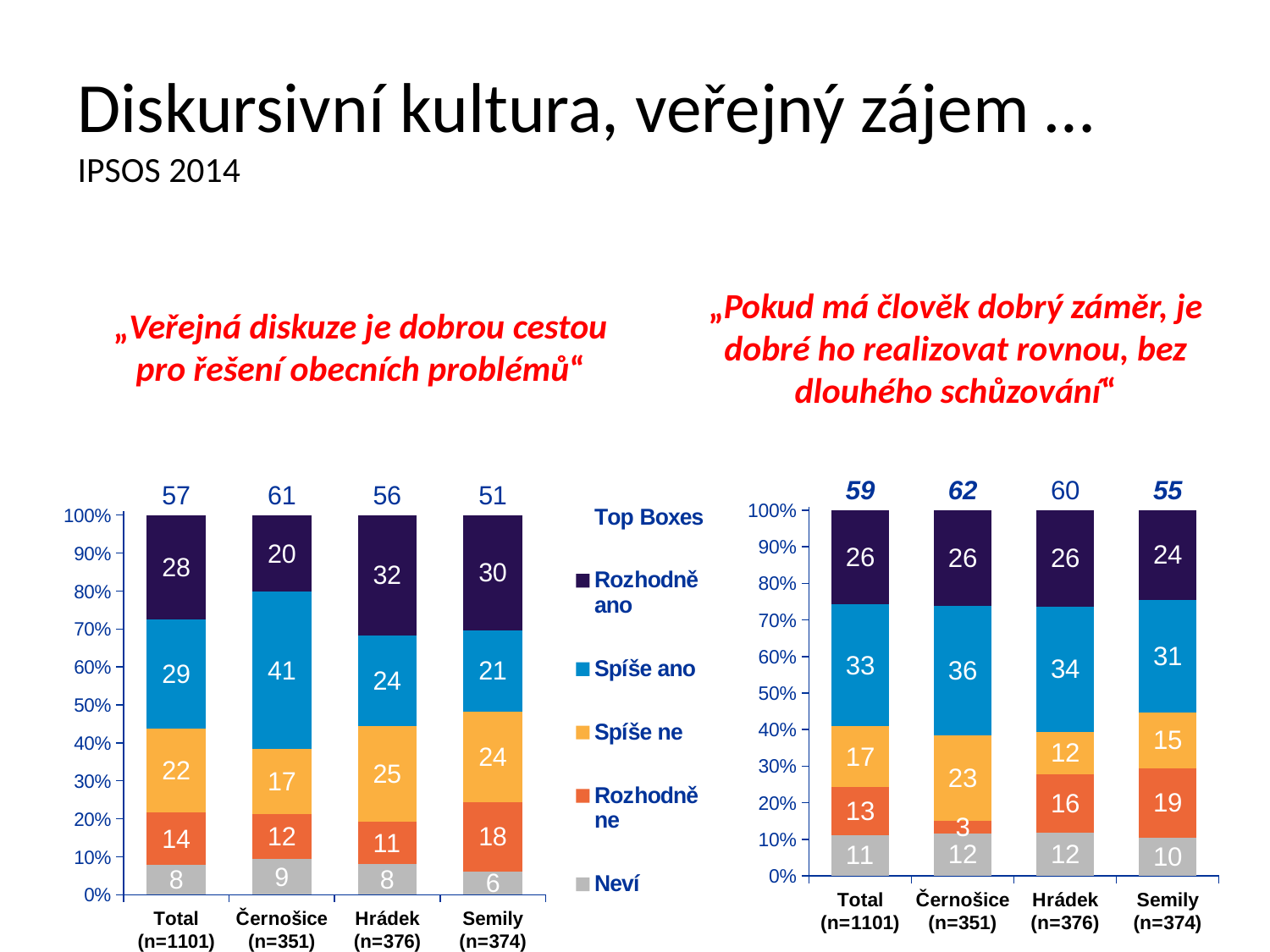
Which legend entry is shown in the light blue colour? Spíše ano In the left chart, which category has the highest Top Boxes value shown above the bars? Černošice (n=351) In the left chart ("Veřejná diskuze je dobrou cestou pro řešení obecních problémů"), what is the value of "Spíše ano" for Černošice (n=351)? 41 In the right chart, which is larger: the "Spíše ne" value for Černošice (n=351) or for Hrádek (n=376)? Černošice (n=351) In the right chart, which category has the lowest Top Boxes value shown above the bars? Semily (n=374) How many series does the legend between the two charts list? 6 In the left chart, what is the "Neví" value for Semily (n=374)? 6 In the right chart, what is the Top Boxes value shown above the bar for Hrádek (n=376)? 60 In the right chart ("Pokud má člověk dobrý záměr..."), what is the value of "Rozhodně ne" for Černošice (n=351)? 3 What type of chart is the right chart? Stacked bar chart In the left chart, what is the difference between the "Rozhodně ano" values for Hrádek (n=376) and Černošice (n=351)? 12 How many categories are shown on the x axis of the left chart? 4